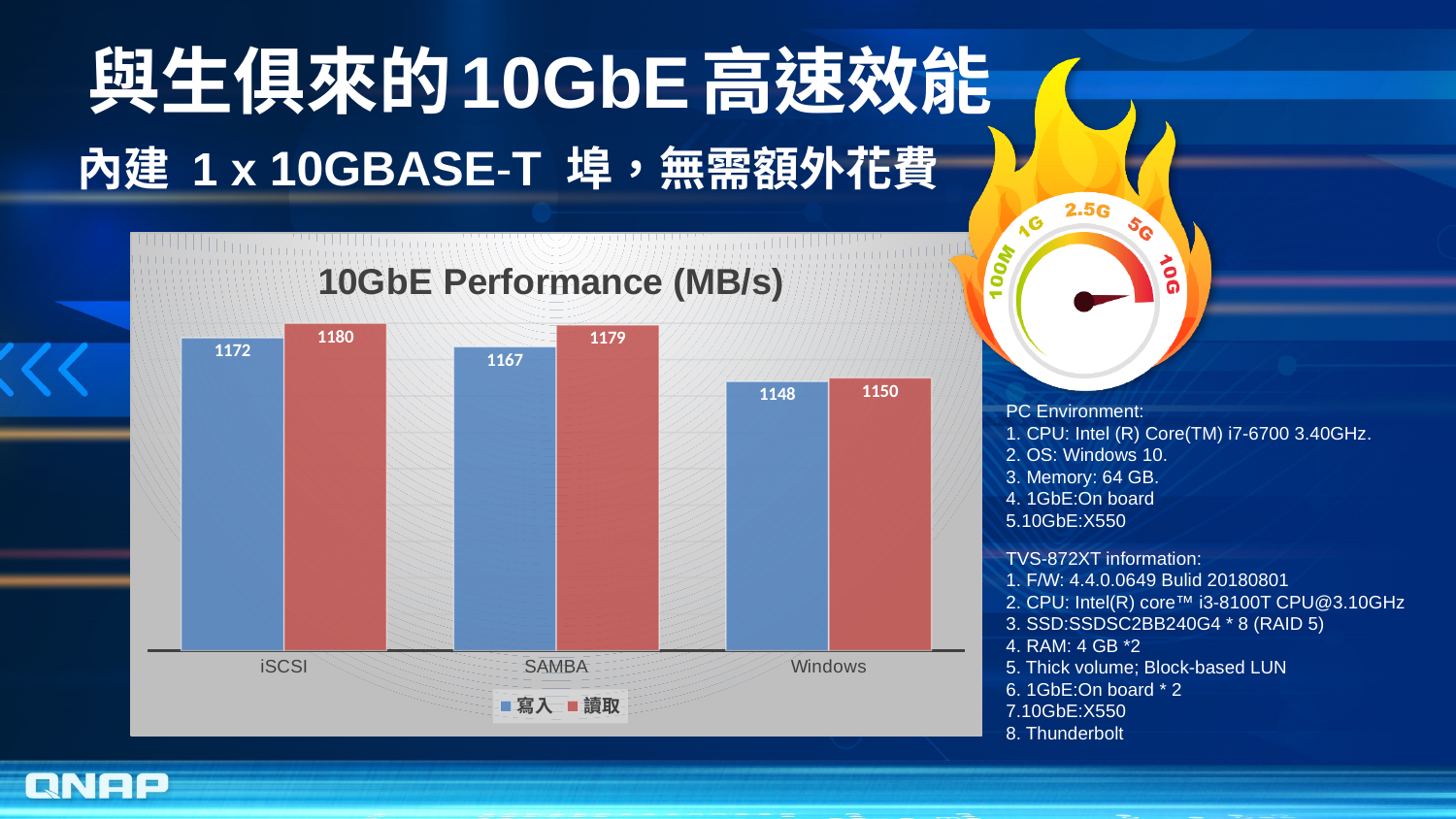
What is the title of the chart on the slide? 10GbE Performance (MB/s) What is the 讀取 (read) value for SAMBA in the 10GbE Performance chart? 1179 In the 10GbE Performance chart, which is larger: the 寫入 value for SAMBA or the 寫入 value for Windows? SAMBA How many categories are shown on the x axis of the 10GbE Performance chart? 3 What is the difference between the 寫入 values for iSCSI and Windows in the 10GbE Performance chart? 24 What is the 讀取 (read) value for Windows in the 10GbE Performance chart? 1150 Which category has the lowest 寫入 (write) value in the 10GbE Performance chart? Windows What kind of chart is the 10GbE Performance chart? bar chart Which category has the highest 讀取 (read) value in the 10GbE Performance chart? iSCSI What is the 寫入 (write) value for iSCSI in the 10GbE Performance chart? 1172 How many series does the legend of the 10GbE Performance chart list? 2 What is the difference between the 讀取 and 寫入 values for iSCSI in the 10GbE Performance chart? 8